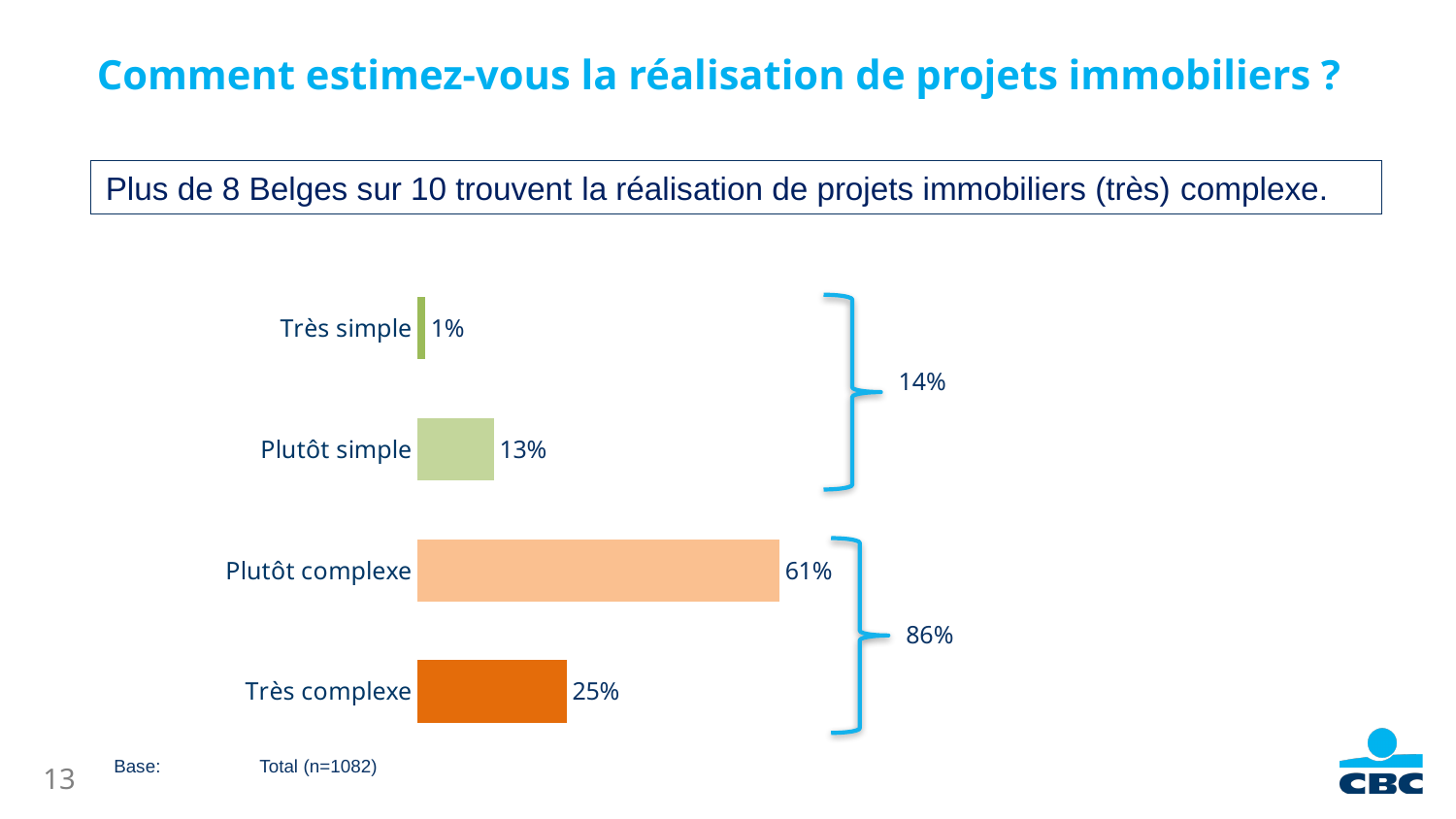
How many categories are shown in the chart? 4 What is the value for "Plutôt simple"? 13% What is the value for "Plutôt complexe"? 61% Which is larger, the value for "Plutôt simple" or the value for "Très complexe"? Très complexe Which category has the lowest value? Très simple What is the value for "Très simple"? 1% What is the difference between the values for "Plutôt complexe" and "Très complexe"? 36% What combined percentage is shown by the bracket grouping "Plutôt complexe" and "Très complexe"? 86% What combined percentage is shown by the bracket grouping "Très simple" and "Plutôt simple"? 14% Which category has the highest value? Plutôt complexe What kind of chart is shown on the slide? Bar chart What is the value for "Très complexe"? 25%